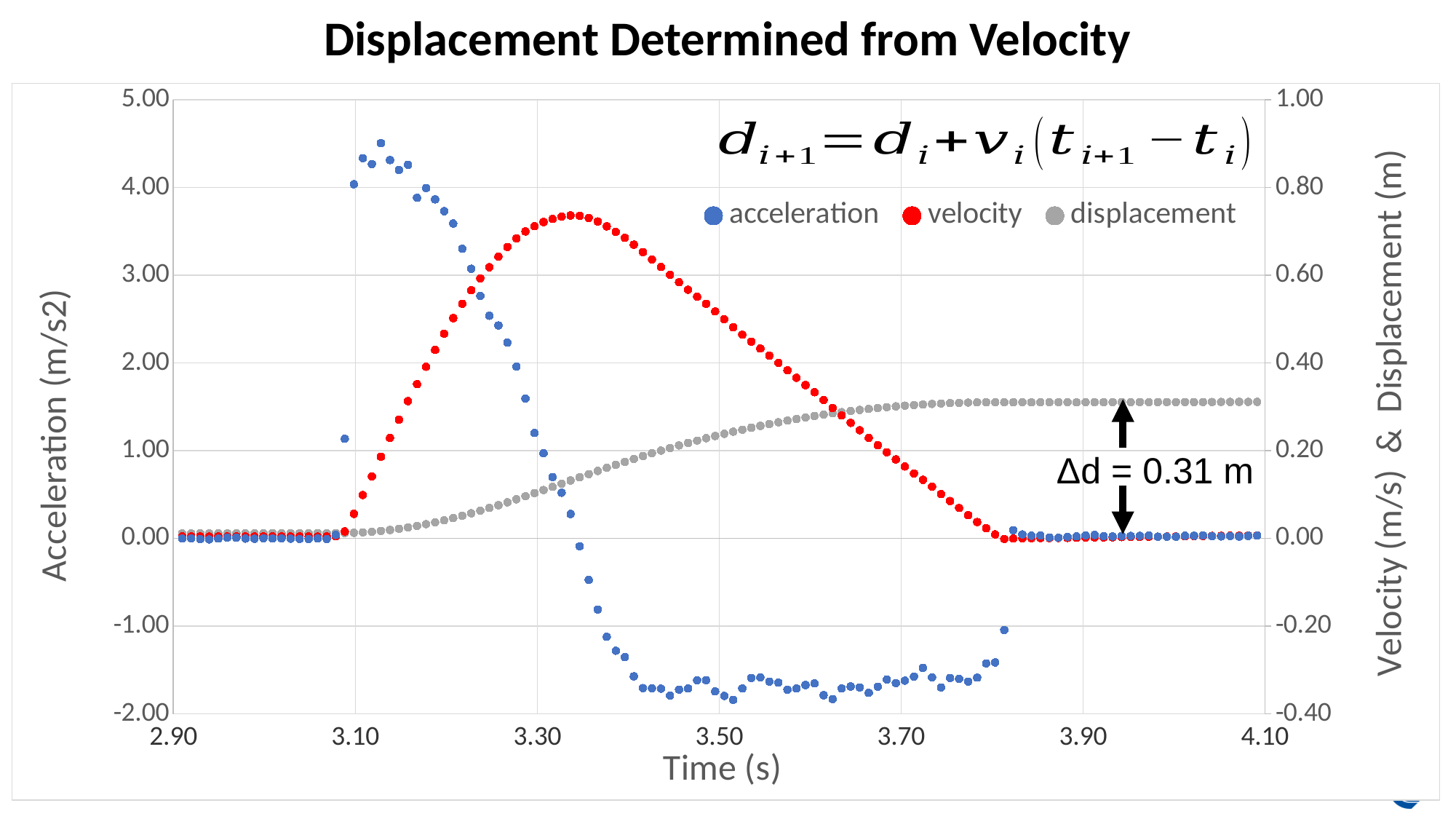
Does the displacement series rise or fall as time increases from 3.10 s to 3.90 s? rise What value of Δd is annotated on the chart? 0.31 m Is the velocity at time 3.70 s greater or less than 0.40 m/s? less What kind of chart is shown on the slide? scatter chart Is the peak velocity value greater or less than 0.80 m/s? less Is the acceleration at time 3.50 s greater or less than -1.00 m/s2? less What is the title of the chart? Displacement Determined from Velocity How many series does the legend list? 3 Which series is plotted in red? velocity